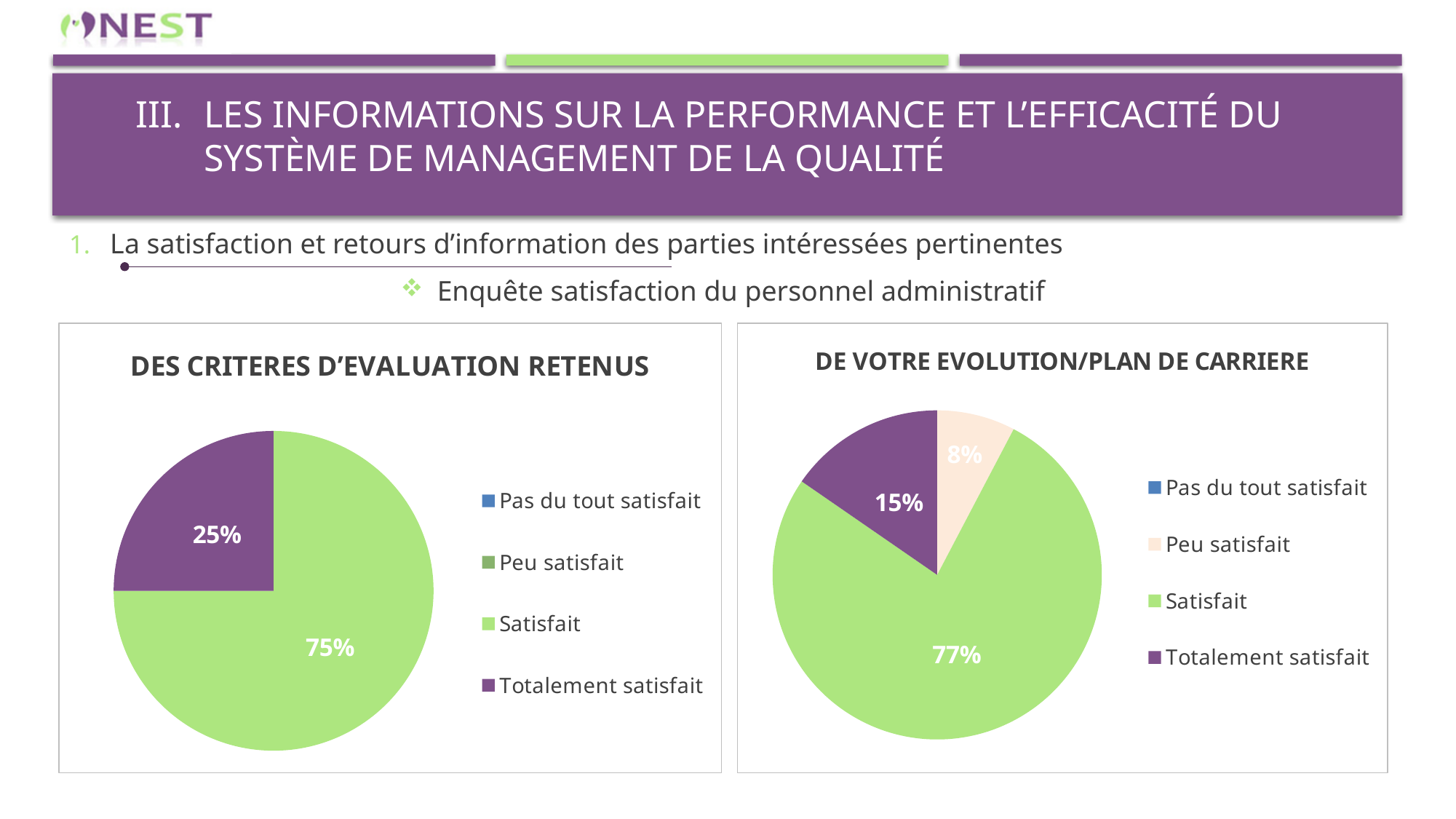
What kind of chart is the one titled "DE VOTRE EVOLUTION/PLAN DE CARRIERE"? Pie chart In the chart titled "DE VOTRE EVOLUTION/PLAN DE CARRIERE", what share of the pie is labelled "Peu satisfait"? 8% In the chart titled "DE VOTRE EVOLUTION/PLAN DE CARRIERE", what is the difference between the "Satisfait" and "Totalement satisfait" slices? 62% In the chart titled "DES CRITERES D'EVALUATION RETENUS", what share of the pie is labelled "Totalement satisfait"? 25% In the chart titled "DE VOTRE EVOLUTION/PLAN DE CARRIERE", which is larger: the "Totalement satisfait" slice or the "Peu satisfait" slice? Totalement satisfait In the chart titled "DE VOTRE EVOLUTION/PLAN DE CARRIERE", what share of the pie is labelled "Totalement satisfait"? 15% In the chart titled "DE VOTRE EVOLUTION/PLAN DE CARRIERE", which labelled slice is the smallest? Peu satisfait In the chart titled "DES CRITERES D'EVALUATION RETENUS", what is the difference between the "Satisfait" and "Totalement satisfait" slices? 50% In the chart titled "DES CRITERES D'EVALUATION RETENUS", how many entries does the legend list? 4 In the chart titled "DES CRITERES D'EVALUATION RETENUS", which category has the largest slice? Satisfait